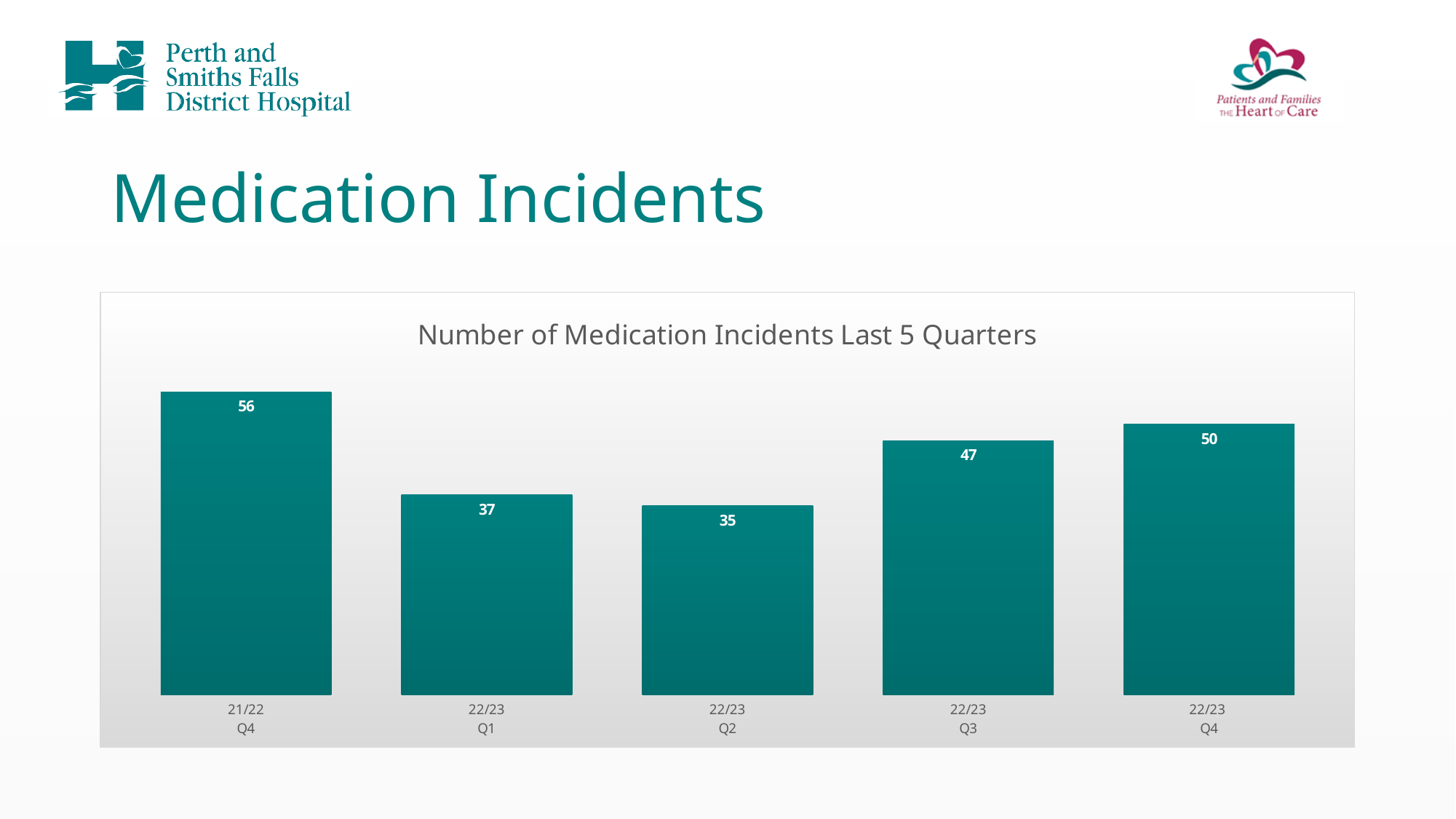
Which quarter has the lowest number of medication incidents? 22/23 Q2 Which quarter has the highest number of medication incidents? 21/22 Q4 What is the difference in medication incidents between 21/22 Q4 and 22/23 Q1? 19 What is the title of the chart? Number of Medication Incidents Last 5 Quarters Which has more medication incidents, 22/23 Q1 or 22/23 Q3? 22/23 Q3 What is the difference in medication incidents between 22/23 Q4 and 22/23 Q3? 3 Do the medication incidents rise or fall from 22/23 Q2 to 22/23 Q4? Rise What is the number of medication incidents for 22/23 Q4? 50 What is the number of medication incidents for 22/23 Q2? 35 What kind of chart is shown on the slide? Bar chart How many quarters are shown in the chart? 5 What is the number of medication incidents for 21/22 Q4? 56